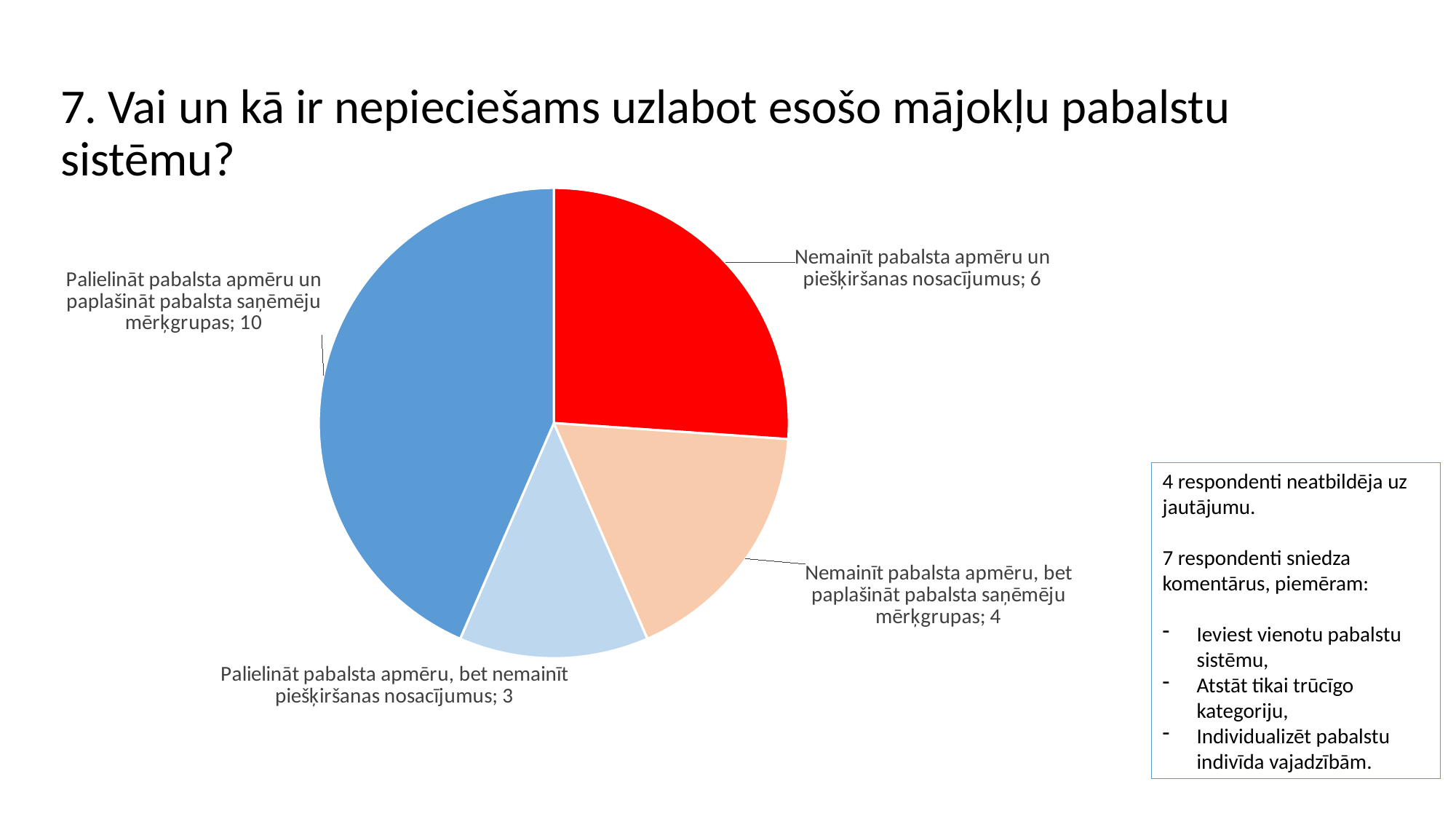
Which is larger: the value for "Nemainīt pabalsta apmēru un piešķiršanas nosacījumus" or for "Nemainīt pabalsta apmēru, bet paplašināt pabalsta saņēmēju mērķgrupas"? Nemainīt pabalsta apmēru un piešķiršanas nosacījumus What is the value for "Palielināt pabalsta apmēru un paplašināt pabalsta saņēmēju mērķgrupas"? 10 What is the difference between the values for "Palielināt pabalsta apmēru un paplašināt pabalsta saņēmēju mērķgrupas" and "Nemainīt pabalsta apmēru un piešķiršanas nosacījumus"? 4 How many slices does the pie chart have? 4 What is the value for "Nemainīt pabalsta apmēru, bet paplašināt pabalsta saņēmēju mērķgrupas"? 4 What is the value for "Palielināt pabalsta apmēru, bet nemainīt piešķiršanas nosacījumus"? 3 What is the total of all the values shown in the pie chart? 23 Which category has the smallest slice of the pie? Palielināt pabalsta apmēru, bet nemainīt piešķiršanas nosacījumus What colour is the slice for "Nemainīt pabalsta apmēru un piešķiršanas nosacījumus"? red Which category has the largest slice of the pie? Palielināt pabalsta apmēru un paplašināt pabalsta saņēmēju mērķgrupas What is the value for "Nemainīt pabalsta apmēru un piešķiršanas nosacījumus"? 6 What type of chart is shown on the slide? pie chart